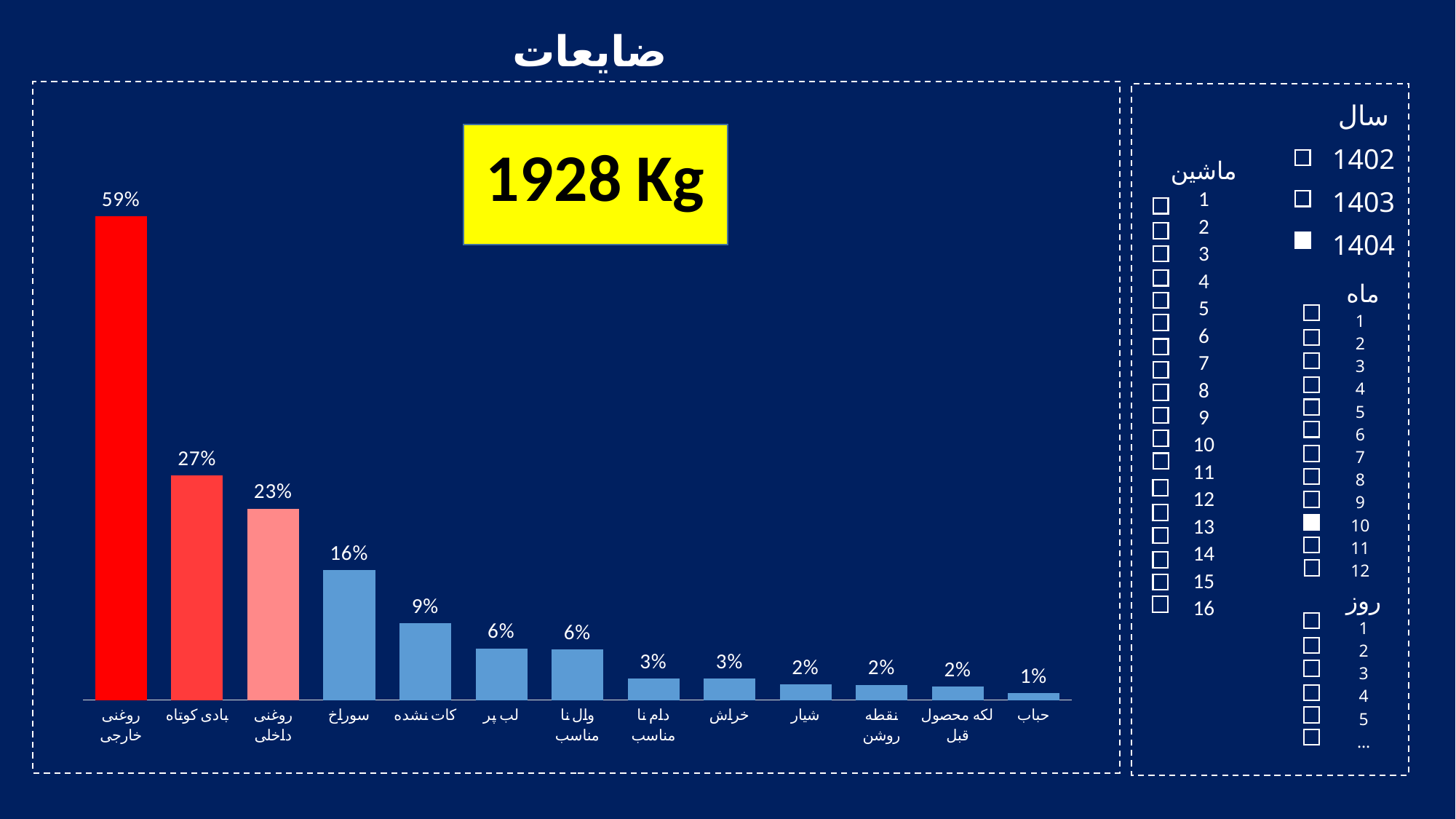
What total weight is shown in the yellow box above the chart? 1928 Kg What is the value for سوراخ? 16% What is the value for کات نشده? 9% How many categories are shown in the bar chart? 13 Which category has the lowest value? حباب Which is larger, the value for روغنی داخلی or the value for سوراخ? روغنی داخلی What is the value for بادی کوتاه? 27% What type of chart is shown on the slide? bar chart What is the value for روغنی خارجی? 59% Which category has the highest value? روغنی خارجی Do the values rise or fall from left to right along the x axis? fall What is the difference between the values for روغنی خارجی and بادی کوتاه? 32%